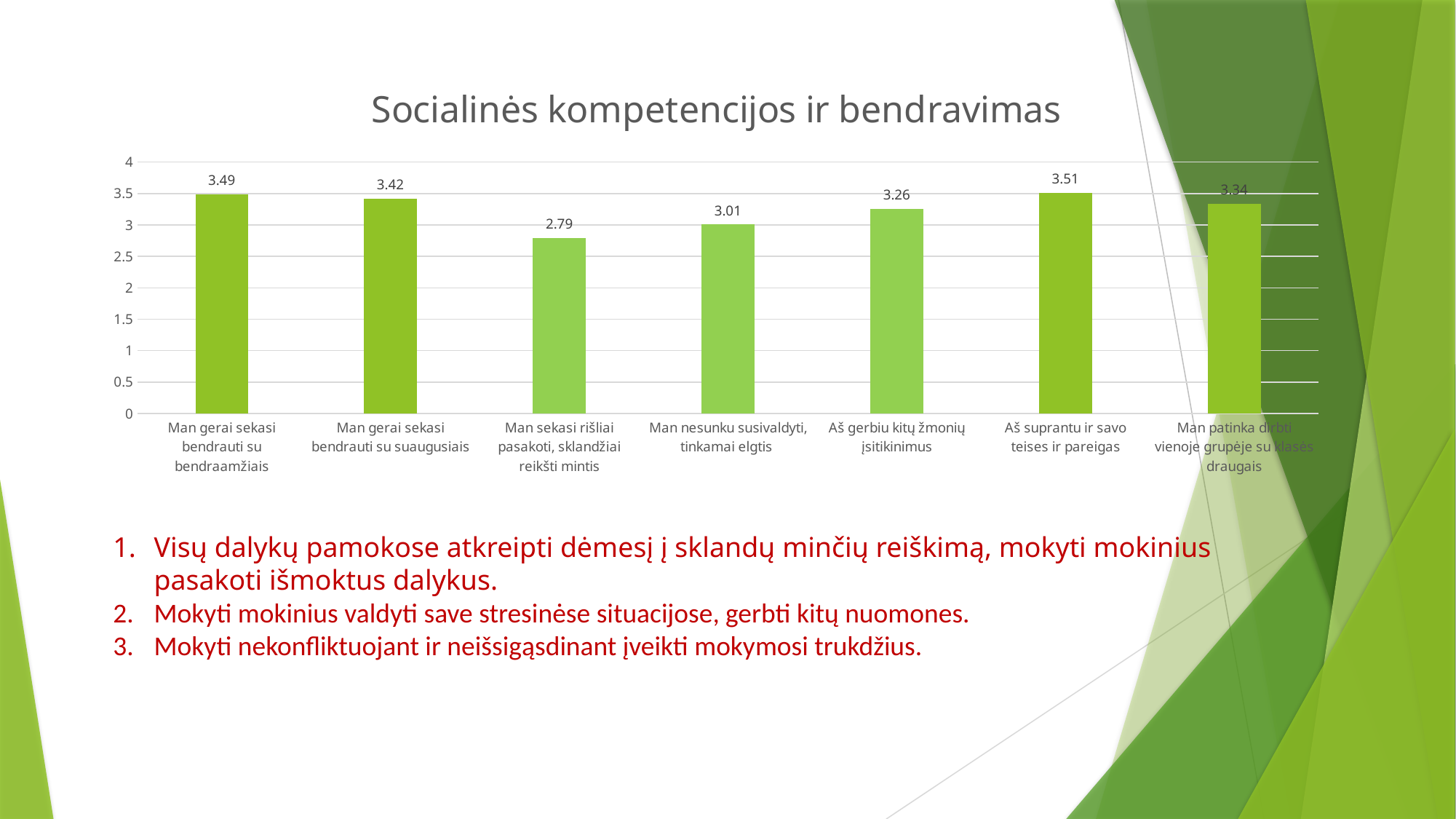
What is the title of the chart? Socialinės kompetencijos ir bendravimas What is the value for "Man sekasi rišliai pasakoti, sklandžiai reikšti mintis"? 2.79 What is the value for "Man nesunku susivaldyti, tinkamai elgtis"? 3.01 What is the value for "Man gerai sekasi bendrauti su bendraamžiais"? 3.49 Which is larger: the value for "Aš gerbiu kitų žmonių įsitikinimus" or the value for "Man nesunku susivaldyti, tinkamai elgtis"? Aš gerbiu kitų žmonių įsitikinimus How many categories are shown in the chart? 7 What is the difference between the values for "Man gerai sekasi bendrauti su bendraamžiais" and "Man gerai sekasi bendrauti su suaugusiais"? 0.07 Is the value for "Man sekasi rišliai pasakoti, sklandžiai reikšti mintis" greater or less than 3? less Which category has the lowest value? Man sekasi rišliai pasakoti, sklandžiai reikšti mintis Which category has the highest value? Aš suprantu ir savo teises ir pareigas What kind of chart is shown on the slide? bar chart What is the value for "Aš gerbiu kitų žmonių įsitikinimus"? 3.26